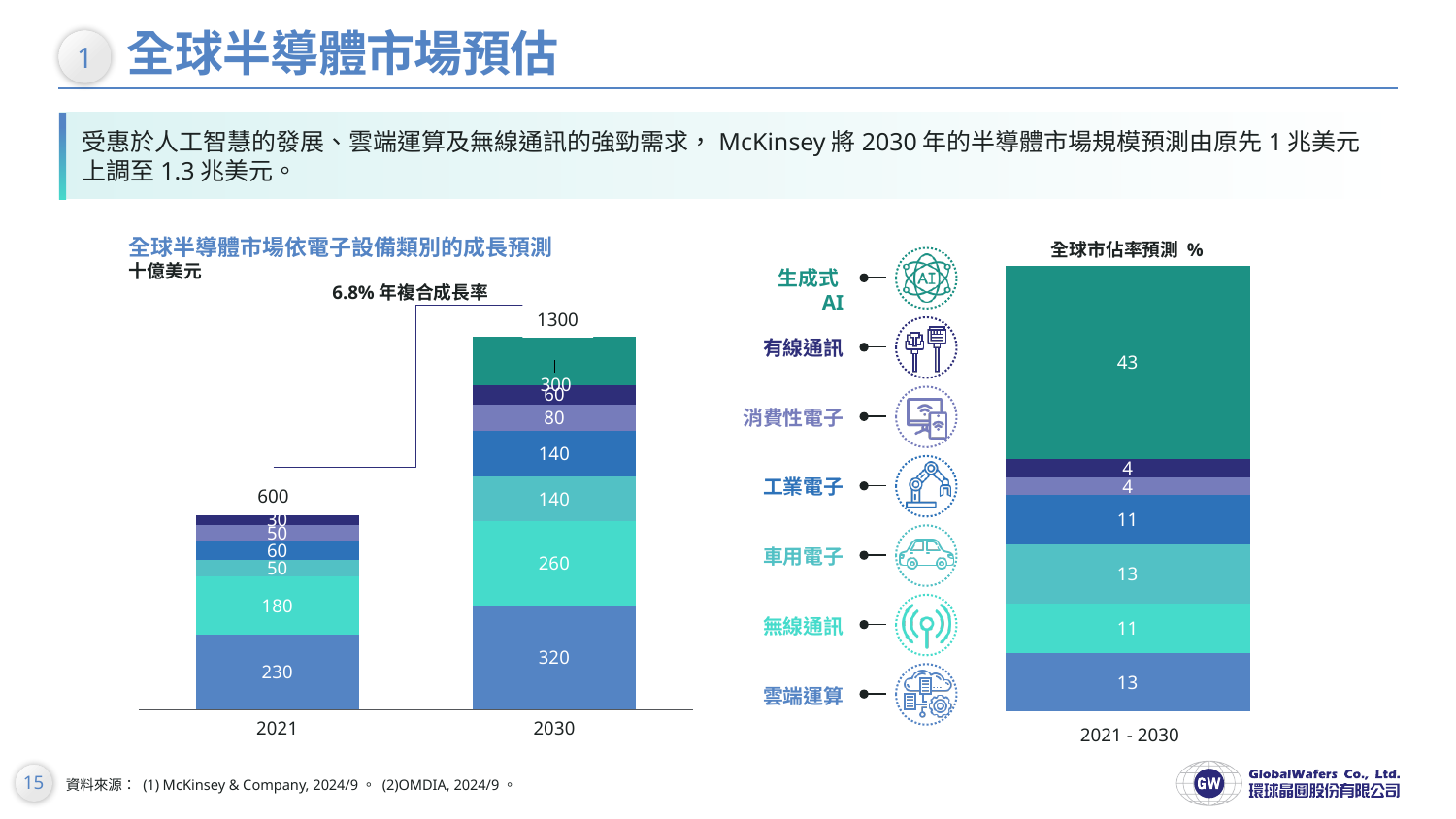
在「全球半導體市場依電子設備類別的成長預測」圖中，2021 年的總市場規模是多少？ 600 在「全球半導體市場依電子設備類別的成長預測」圖中，2030 年生成式 AI 的數值是多少？ 300 在「全球半導體市場依電子設備類別的成長預測」圖中，2030 年雲端運算的數值是多少？ 320 在「全球半導體市場依電子設備類別的成長預測」圖中，2021 年無線通訊的數值是多少？ 180 在「全球半導體市場依電子設備類別的成長預測」圖中，2021 年到 2030 年的年複合成長率是多少？ 6.8% 在「全球市佔率預測 %」圖中，工業電子的市佔率是多少？ 11 在「全球半導體市場依電子設備類別的成長預測」圖中，2030 年的總市場規模是多少？ 1300 在「全球半導體市場依電子設備類別的成長預測」圖中，2030 年的雲端運算與無線通訊，哪一個數值較大？ 雲端運算 這張投影片左側的「全球半導體市場依電子設備類別的成長預測」是什麼類型的圖表？ 堆疊長條圖 在「全球市佔率預測 %」圖中，哪一個類別的市佔率最高？ 生成式 AI 在「全球半導體市場依電子設備類別的成長預測」圖中，雲端運算從 2021 年到 2030 年增加了多少？ 90 在「全球市佔率預測 %」圖中，生成式 AI 的市佔率是多少？ 43